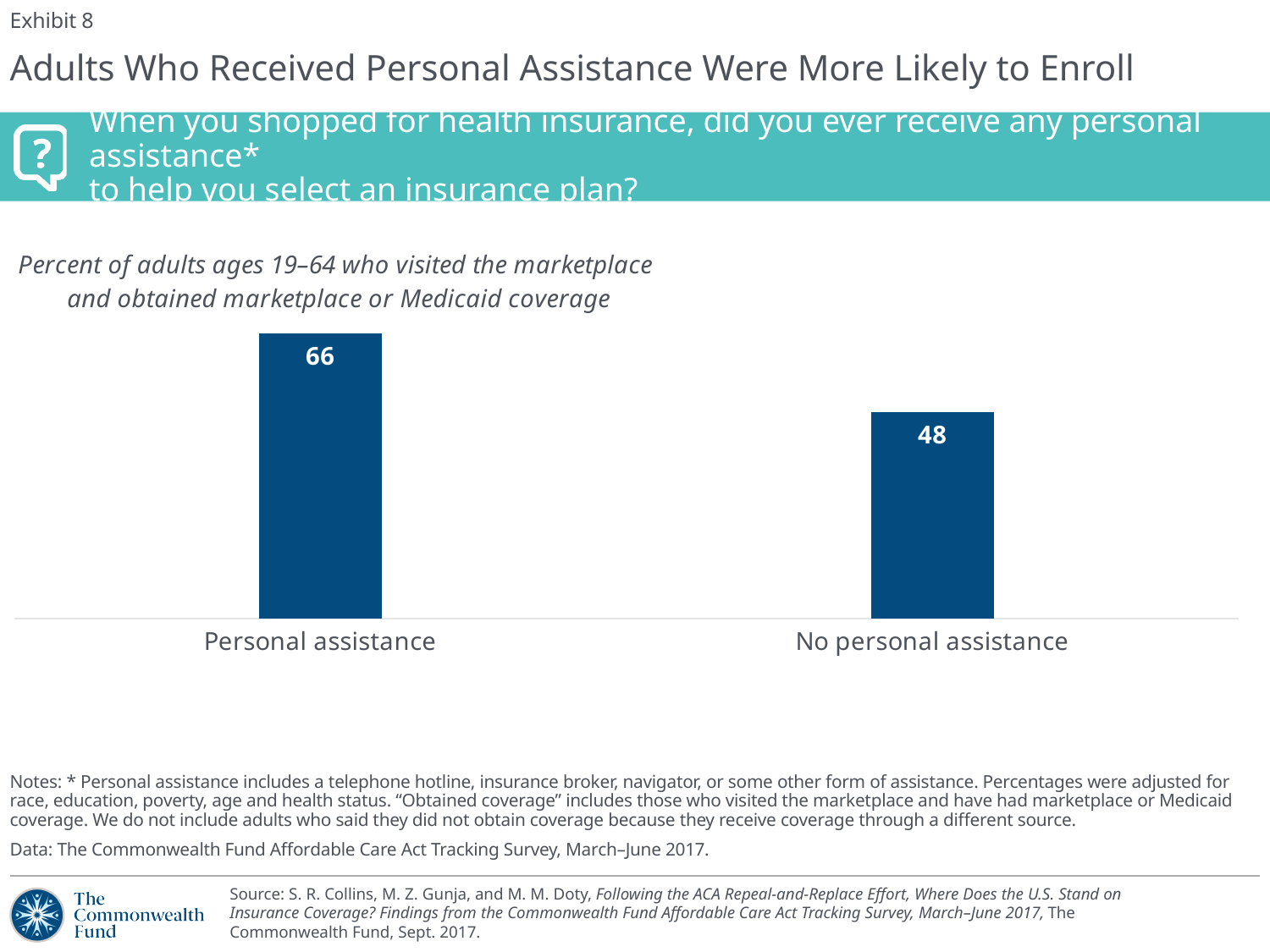
Which category has the highest value? Personal assistance How many categories are shown in the chart? 2 Which is larger, the value for Personal assistance or for No personal assistance? Personal assistance What is the value for No personal assistance? 48 What kind of chart is shown on the slide? Bar chart Which category has the lowest value? No personal assistance What is the exhibit number shown on the slide? Exhibit 8 What is the value for Personal assistance? 66 What is the title of the slide? Adults Who Received Personal Assistance Were More Likely to Enroll What is the difference between the values for Personal assistance and No personal assistance? 18